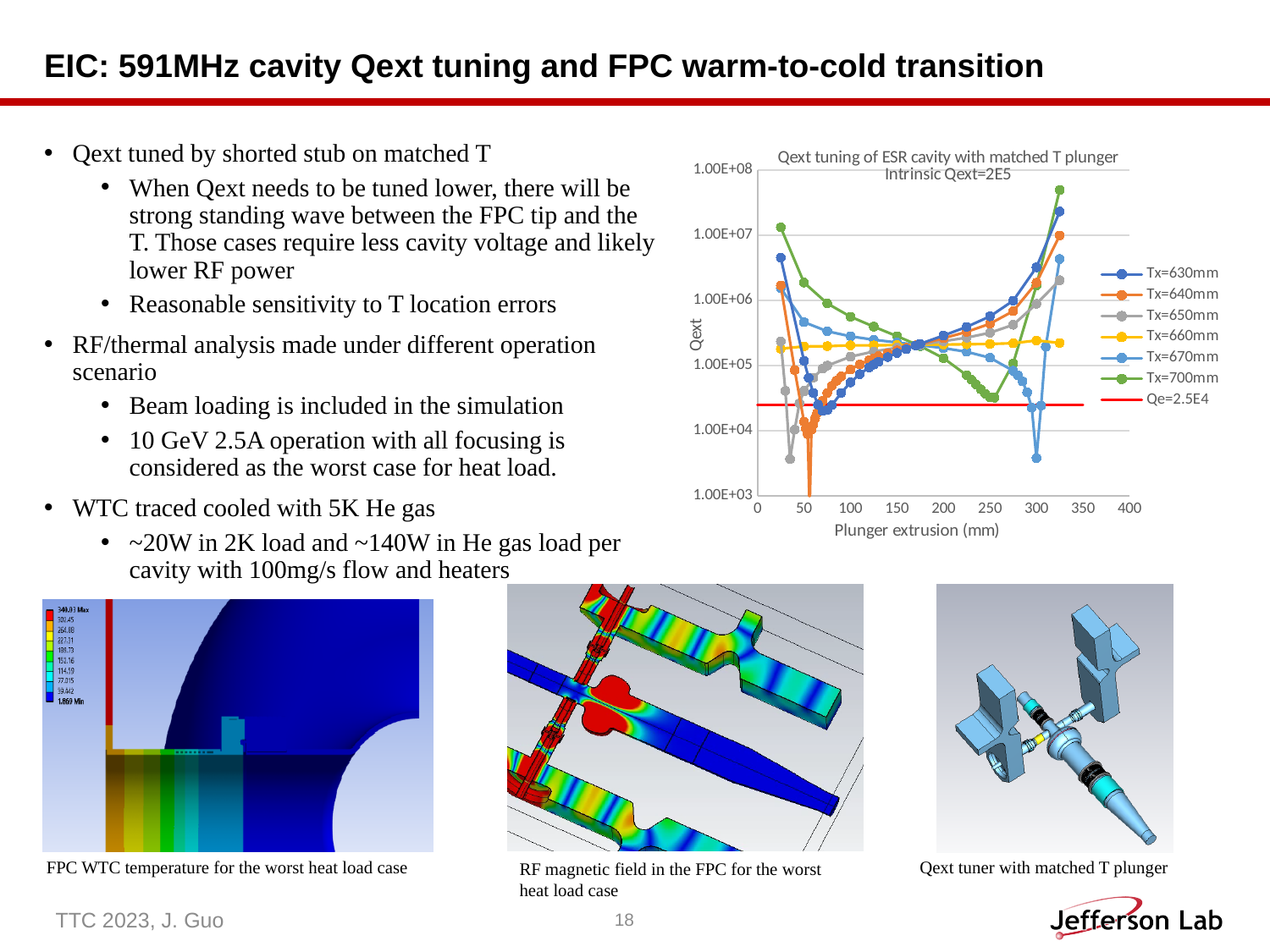
What is the title of the chart? Qext tuning of ESR cavity with matched T plunger Intrinsic Qext=2E5 How many series does the legend of the chart list? 7 What is the label of the x axis of the chart? Plunger extrusion (mm) Between plunger extrusions of about 25 mm and 250 mm, does the Tx=700mm series rise or fall? fall Is the value of the Tx=630mm series at a plunger extrusion of about 325 mm greater or less than 1.00E+07? greater At a plunger extrusion of about 25 mm, which series has the higher Qext, Tx=700mm or Tx=650mm? Tx=700mm Is the value of the Tx=700mm series at a plunger extrusion of about 25 mm greater or less than 1.00E+07? greater At a plunger extrusion of about 325 mm, which series has the higher Qext, Tx=700mm or Tx=660mm? Tx=700mm What kind of chart is shown on the slide? line chart Is the lowest value of the Tx=670mm series, near a plunger extrusion of 300 mm, greater or less than 1.00E+04? less Between plunger extrusions of about 75 mm and 325 mm, does the Tx=640mm series rise or fall? rise